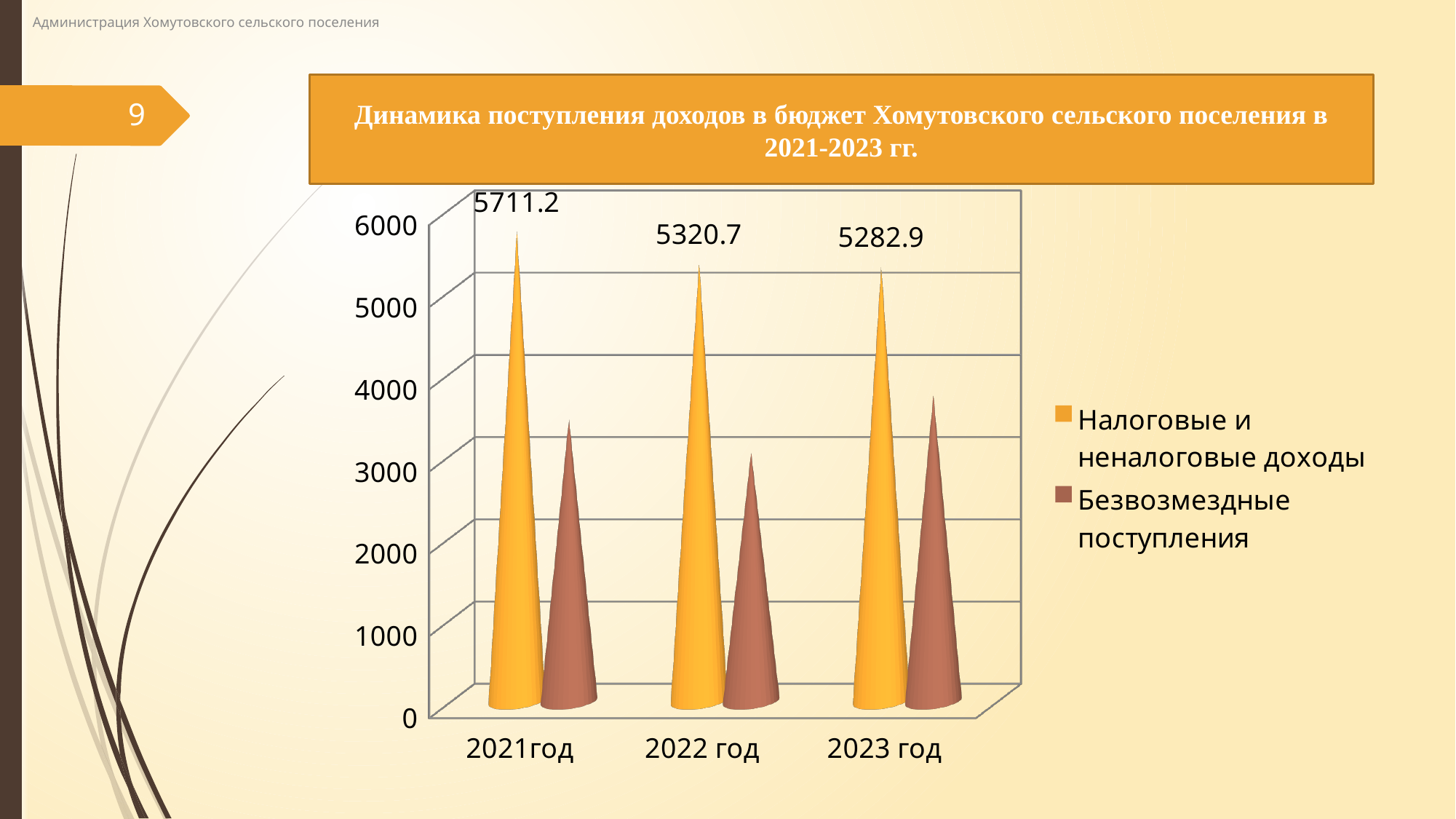
What is the value for Налоговые и неналоговые доходы in 2022 год? 5320.7 What is the difference between the Налоговые и неналоговые доходы values for 2022 год and 2023 год? 37.8 How many series does the legend list? 2 In which year is the value for Налоговые и неналоговые доходы highest? 2021год What is the difference between the Налоговые и неналоговые доходы values for 2021год and 2022 год? 390.5 Is the value for Безвозмездные поступления in 2022 год greater or less than 4000? less In which year is the value for Налоговые и неналоговые доходы lowest? 2023 год Which is larger in 2021год: Налоговые и неналоговые доходы or Безвозмездные поступления? Налоговые и неналоговые доходы What is the value for Налоговые и неналоговые доходы in 2023 год? 5282.9 What is the value for Налоговые и неналоговые доходы in 2021год? 5711.2 Is the value for Безвозмездные поступления in 2023 год greater or less than 3000? greater Do the values for Налоговые и неналоговые доходы rise or fall from 2021год to 2023 год? fall